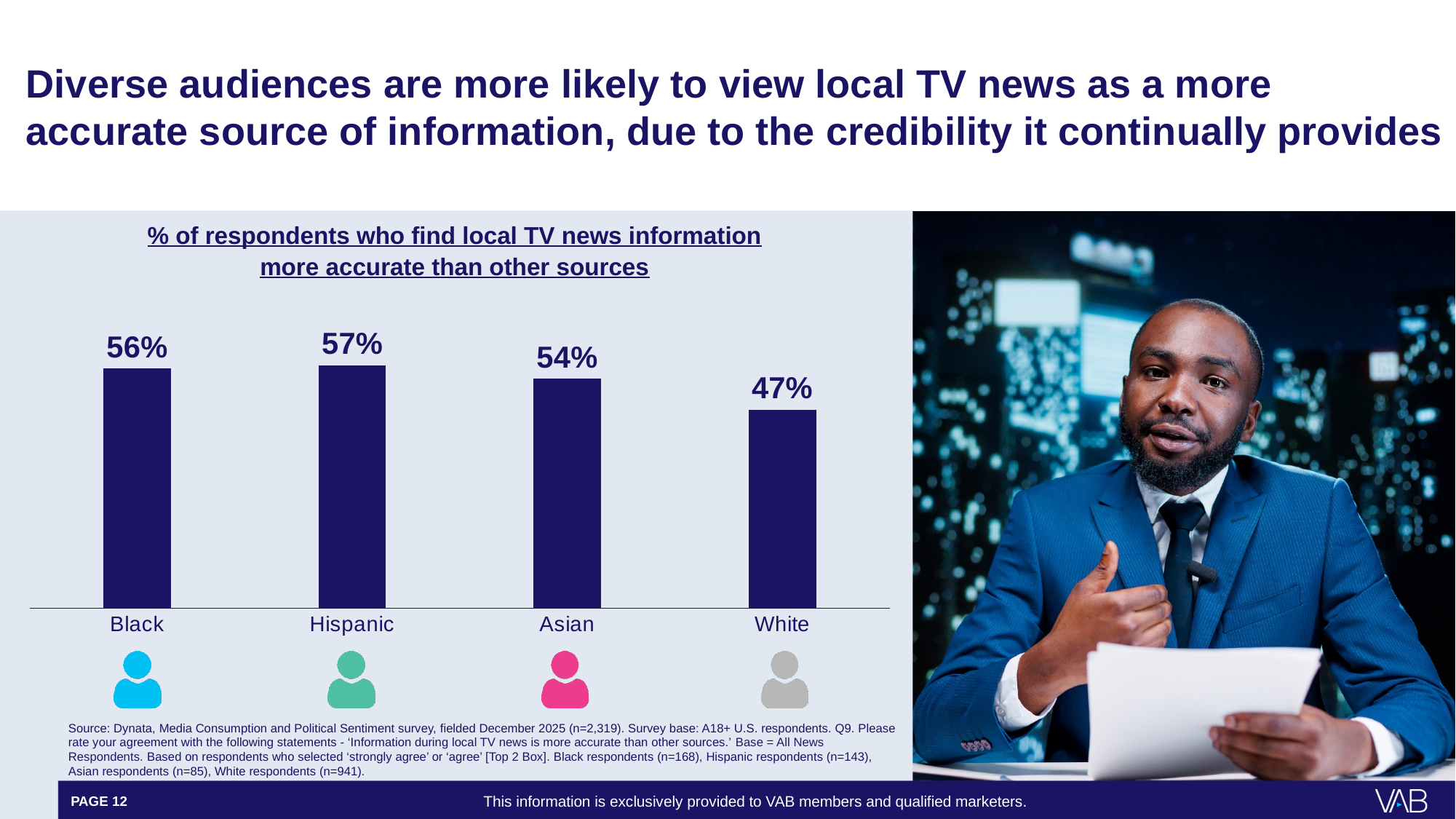
Which group has the lowest percentage of respondents who find local TV news information more accurate than other sources? White What is the difference in percentage points between Hispanic and White respondents? 10 percentage points What percentage of Black respondents find local TV news information more accurate than other sources? 56% Which is larger, the value for Asian respondents or the value for White respondents? Asian What kind of chart is shown on the slide? Bar chart What percentage of White respondents find local TV news information more accurate than other sources? 47% What is the title of the chart? % of respondents who find local TV news information more accurate than other sources How many groups are shown in the chart? 4 What is the difference in percentage points between Black and Asian respondents? 2 percentage points What percentage of Asian respondents find local TV news information more accurate than other sources? 54% Which group has the highest percentage of respondents who find local TV news information more accurate than other sources? Hispanic What percentage of Hispanic respondents find local TV news information more accurate than other sources? 57%